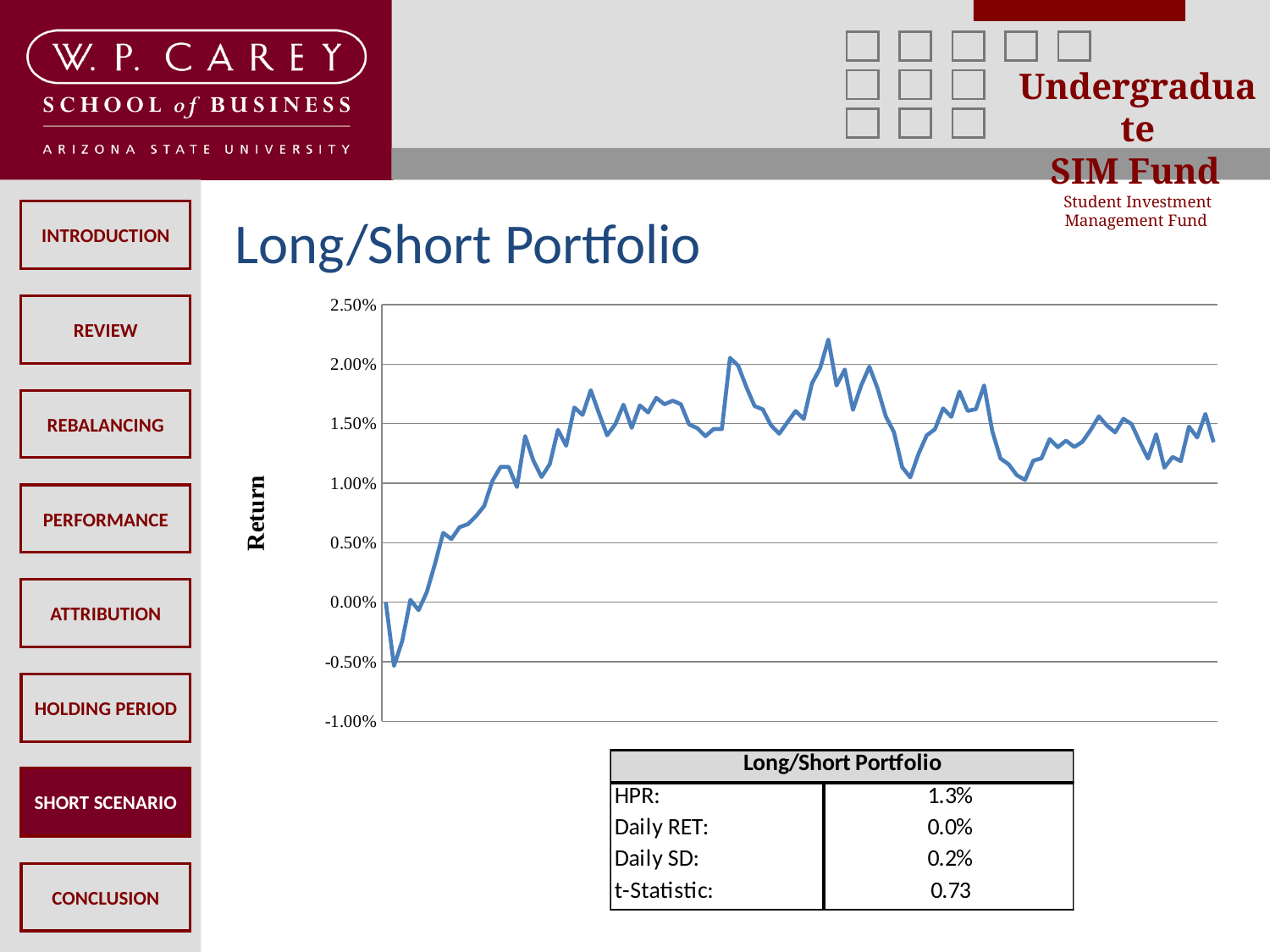
Does the line ever rise above 2.50%? No Is the lowest value of the line greater or less than 0.00%? less Is the value at the start of the line (left side) greater or less than 0.50%? less What is the highest value shown on the chart's vertical axis? 2.50% What kind of chart is shown on the slide? line chart What is the title of the chart's vertical axis? Return How many data series are plotted on the chart? 1 Overall, does the return rise or fall from the left of the chart to the right? rise